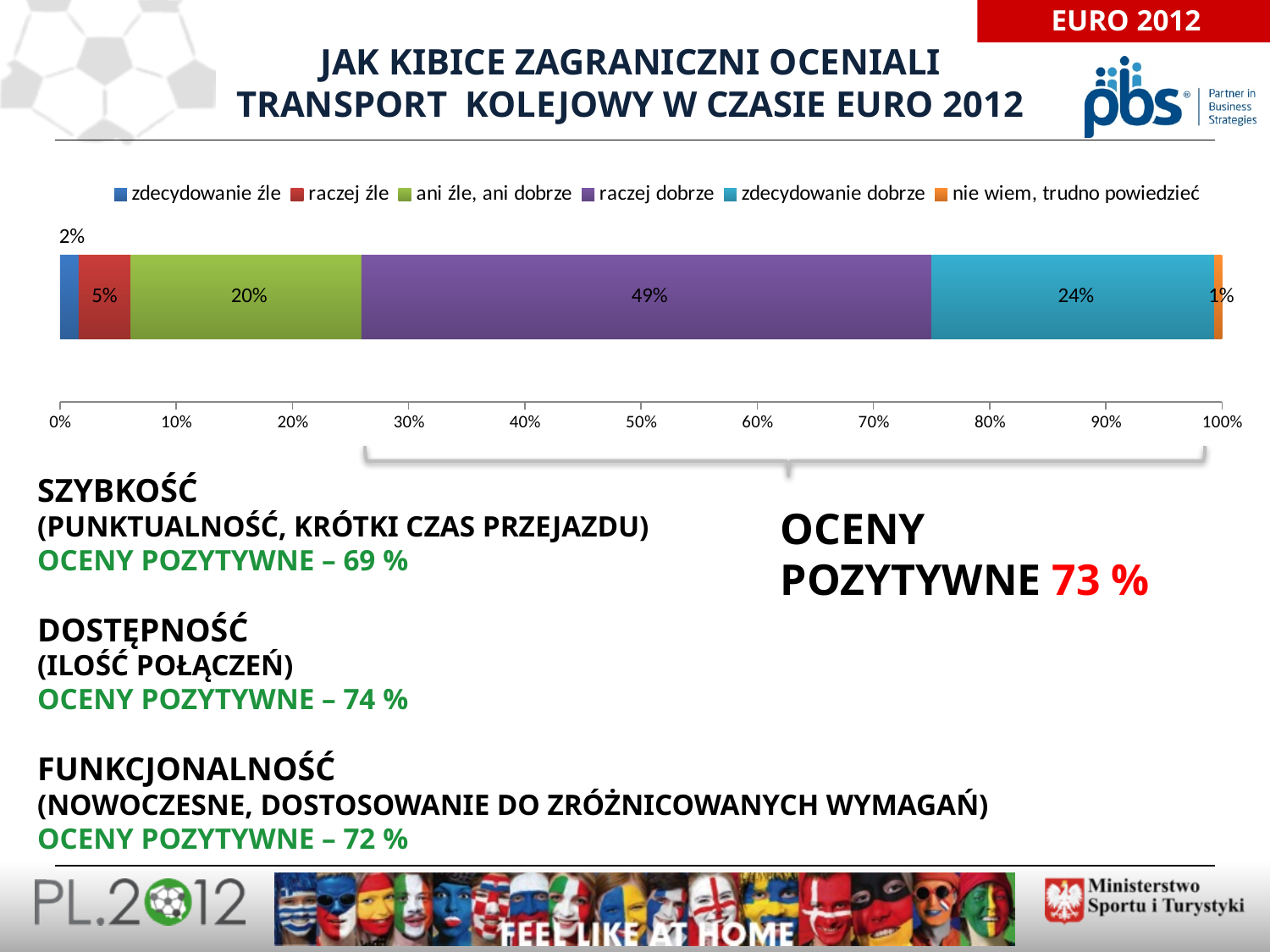
How many series does the legend list? 6 What is the value for "ani źle, ani dobrze"? 20% Which response category has the highest value? raczej dobrze What is the value for "zdecydowanie źle"? 2% What is the difference between the values for "raczej dobrze" and "zdecydowanie dobrze"? 25% What is the value for "raczej źle"? 5% What kind of chart is shown on the slide? stacked bar chart Which is larger, the value for "ani źle, ani dobrze" or the value for "raczej źle"? ani źle, ani dobrze Which response category has the lowest value? nie wiem, trudno powiedzieć What is the value for "zdecydowanie dobrze"? 24% What is the value for "raczej dobrze"? 49% What is the value for "nie wiem, trudno powiedzieć"? 1%